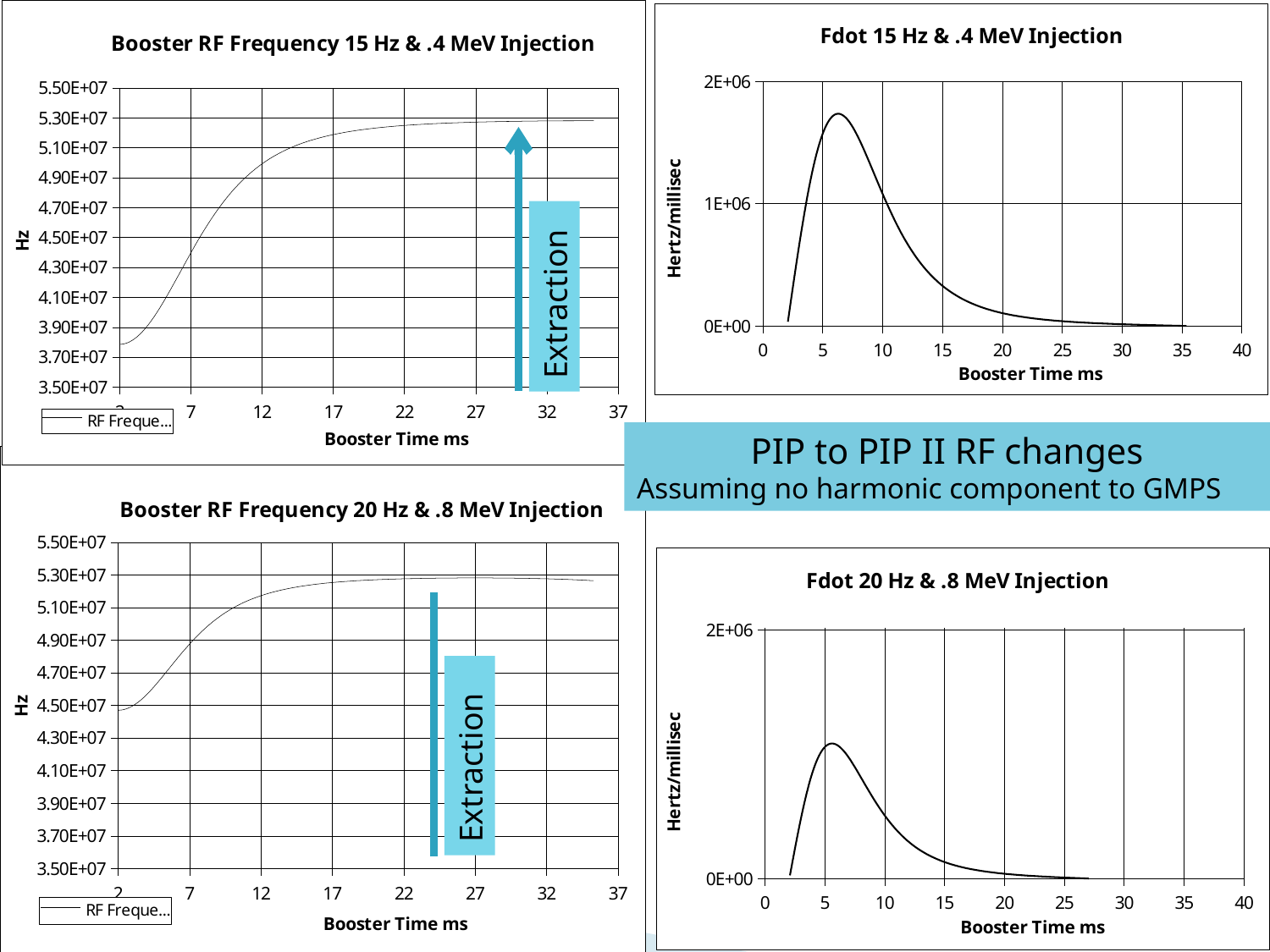
What is the y-axis label of the 'Fdot 20 Hz & .8 MeV Injection' chart? Hertz/millisec Which chart has the higher peak value: 'Fdot 15 Hz & .4 MeV Injection' or 'Fdot 20 Hz & .8 MeV Injection'? Fdot 15 Hz & .4 MeV Injection Which chart shows a higher RF frequency at the start of the curve: 'Booster RF Frequency 15 Hz & .4 MeV Injection' or 'Booster RF Frequency 20 Hz & .8 MeV Injection'? Booster RF Frequency 20 Hz & .8 MeV Injection In the 'Fdot 20 Hz & .8 MeV Injection' chart, is the peak value greater or less than 2E+06 Hertz/millisec? less In the 'Booster RF Frequency 15 Hz & .4 MeV Injection' chart, is the frequency at the start of the curve (around 2 ms) greater or less than 4.10E+07 Hz? less In the 'Fdot 15 Hz & .4 MeV Injection' chart, after the peak near 5 ms, does the value rise or fall as Booster Time increases? Fall In the 'Booster RF Frequency 20 Hz & .8 MeV Injection' chart, is the frequency at the start of the curve (around 2 ms) greater or less than 4.30E+07 Hz? greater In the 'Booster RF Frequency 15 Hz & .4 MeV Injection' chart, does the RF frequency rise or fall as Booster Time increases? Rise What kind of chart is the 'Booster RF Frequency 15 Hz & .4 MeV Injection' chart? Line chart How many series does the legend of the 'Booster RF Frequency 20 Hz & .8 MeV Injection' chart list? 1